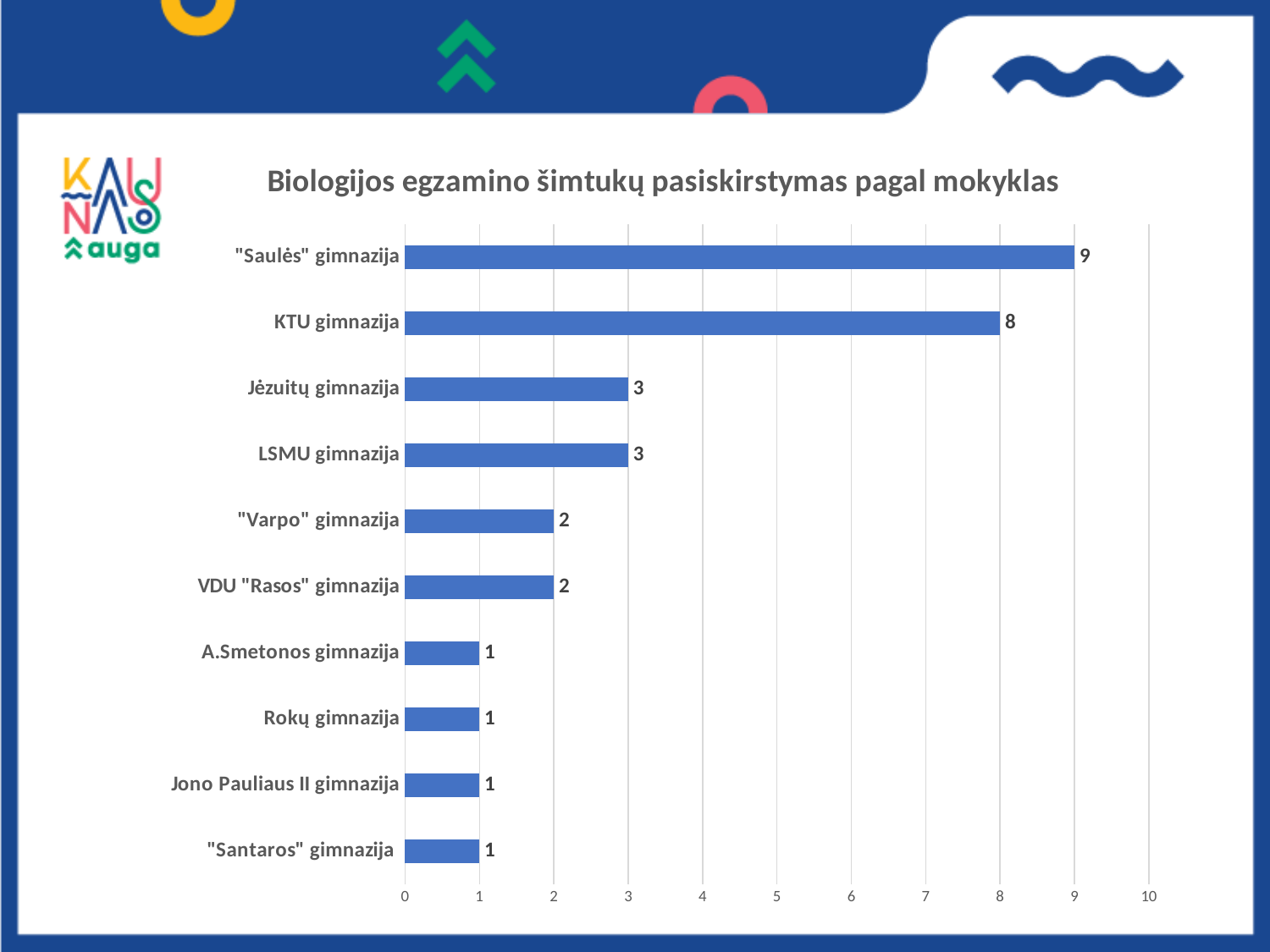
What is the title of the chart? Biologijos egzamino šimtukų pasiskirstymas pagal mokyklas What is the value for "Saulės" gimnazija? 9 What is the difference between the values for "Saulės" gimnazija and KTU gimnazija? 1 What is the value for KTU gimnazija? 8 Which is larger, the value for LSMU gimnazija or the value for VDU "Rasos" gimnazija? LSMU gimnazija Which school has the highest value? "Saulės" gimnazija What is the value for Jono Pauliaus II gimnazija? 1 Is the value for KTU gimnazija greater or less than 5? greater How many schools are shown in the chart? 10 What is the value for "Varpo" gimnazija? 2 What kind of chart is shown on the slide? bar chart What is the difference between the values for KTU gimnazija and Jėzuitų gimnazija? 5